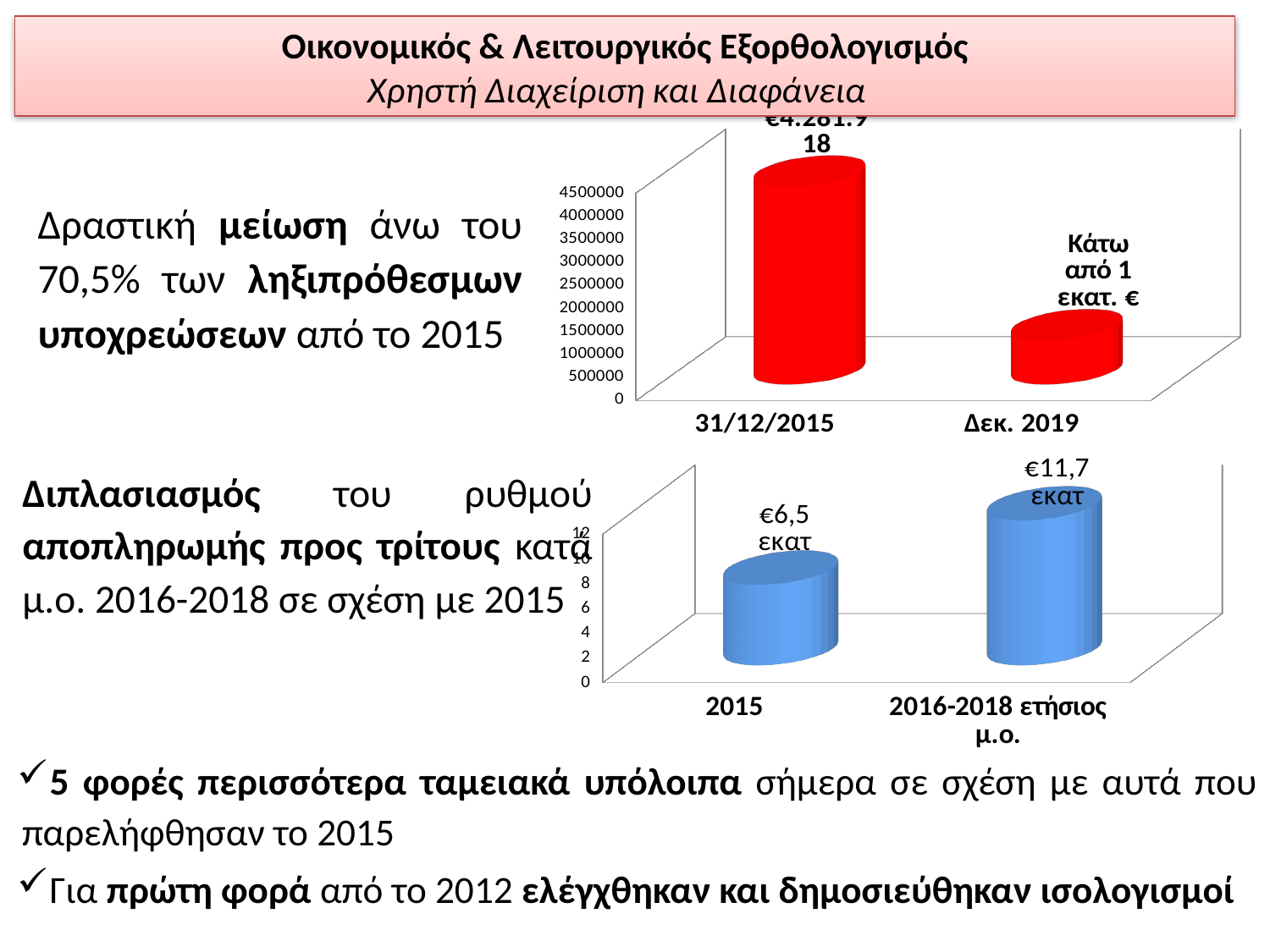
In the bottom chart, do the values rise or fall from 2015 to 2016-2018 ετήσιος μ.ο.? Rise In the bottom chart, which category has the higher value? 2016-2018 ετήσιος μ.ο. What kind of chart is the bottom chart? Bar chart In the top chart, is the value for Δεκ. 2019 greater or less than 1000000? less In the top chart, is the value for 31/12/2015 greater or less than 3000000? greater In the bottom chart, what is the value for 2015? €6,5 εκατ In the bottom chart, what is the difference between the 2016-2018 ετήσιος μ.ο. value and the 2015 value? €5,2 εκατ In the bottom chart, what is the value for 2016-2018 ετήσιος μ.ο.? €11,7 εκατ In the top chart, which category has the higher value, 31/12/2015 or Δεκ. 2019? 31/12/2015 In the top chart, how many categories are plotted? 2 In the top chart, what does the data label above the Δεκ. 2019 bar say? Κάτω από 1 εκατ. € In the bottom chart, how many categories are plotted? 2